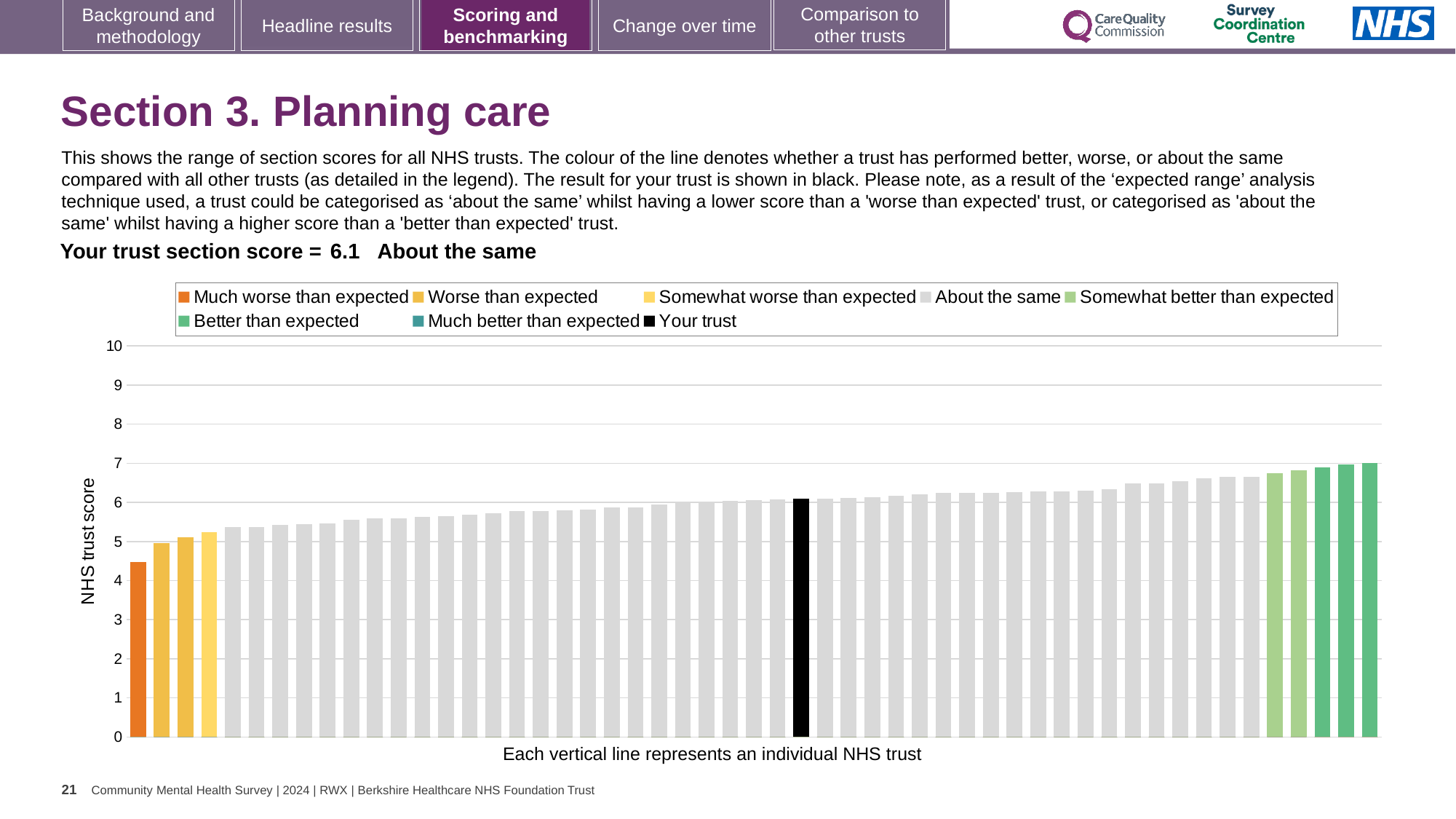
Is the value for the lowest bar (the orange bar) greater or less than 5? less Is the value for the tallest bar in the chart greater or less than 8? less How many entries does the chart legend list? 8 Do the bar values rise or fall from left to right along the x axis? rise Which is larger: the value for your trust (black bar) or the value for the orange 'Much worse than expected' bar? Your trust Which legend category does the lowest bar in the chart belong to? Much worse than expected What kind of chart is shown on the slide? bar chart What is the section score for your trust shown on the slide? 6.1 Which legend category do the tallest bars at the right of the chart belong to? Better than expected What is the label on the vertical axis of the chart? NHS trust score What colour is used for the 'Your trust' bar according to the legend? black Is the value for your trust (the black bar) greater or less than 5? greater